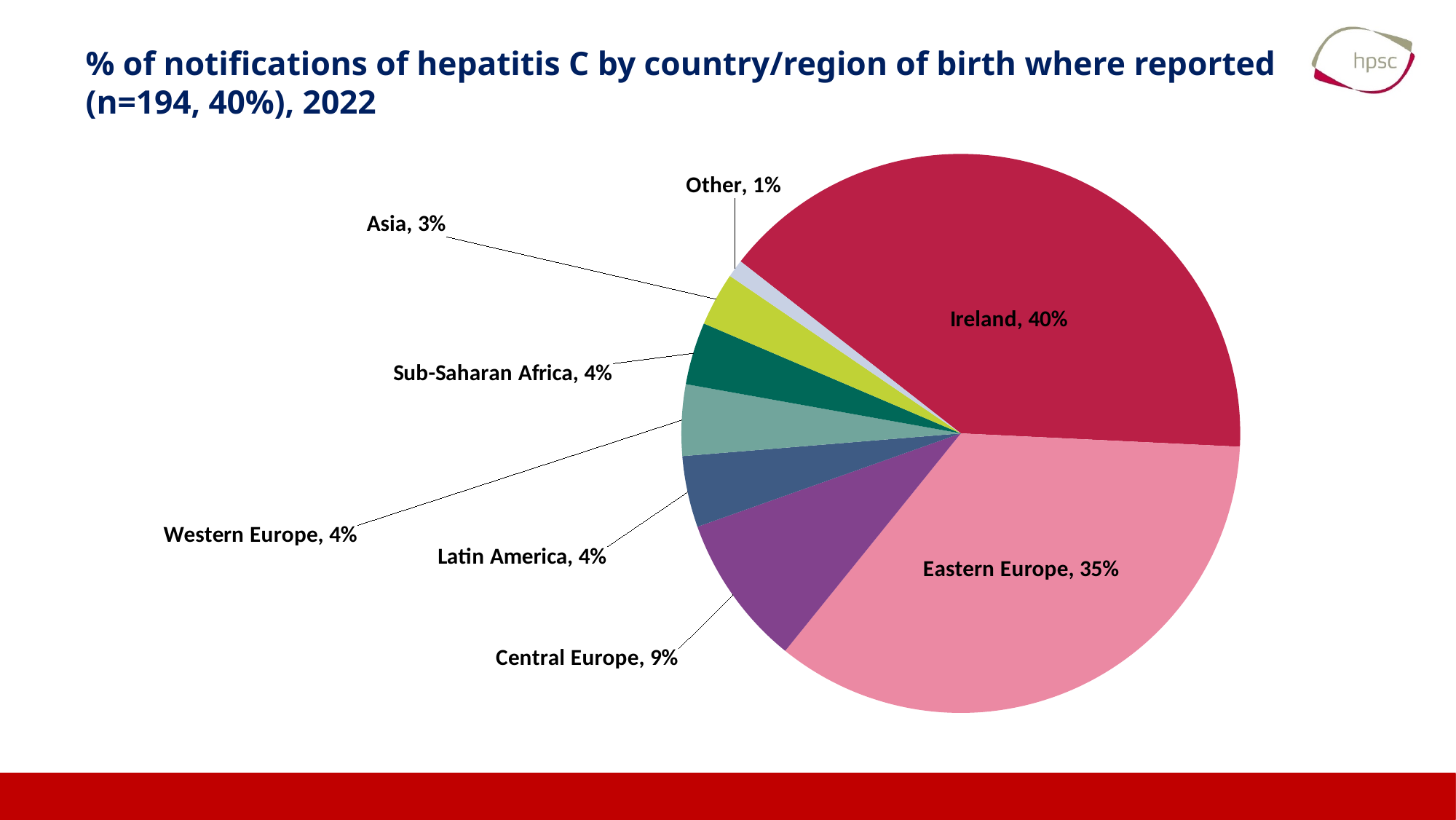
What percentage of notifications is shown for Central Europe? 9% Which country/region of birth has the largest share of notifications? Ireland Which country/region of birth has the smallest share of notifications? Other What is the difference in percentage points between Ireland and Eastern Europe? 5 What is the title of the chart? % of notifications of hepatitis C by country/region of birth where reported (n=194, 40%), 2022 What type of chart is shown on the slide? pie chart What percentage of hepatitis C notifications were for people born in Ireland? 40% Which has a larger share of notifications, Central Europe or Asia? Central Europe How many country/region categories are shown in the pie chart? 8 What percentage of notifications is shown for Asia? 3% What is the difference in percentage points between Central Europe and Sub-Saharan Africa? 5 What percentage of notifications is shown for Eastern Europe? 35%